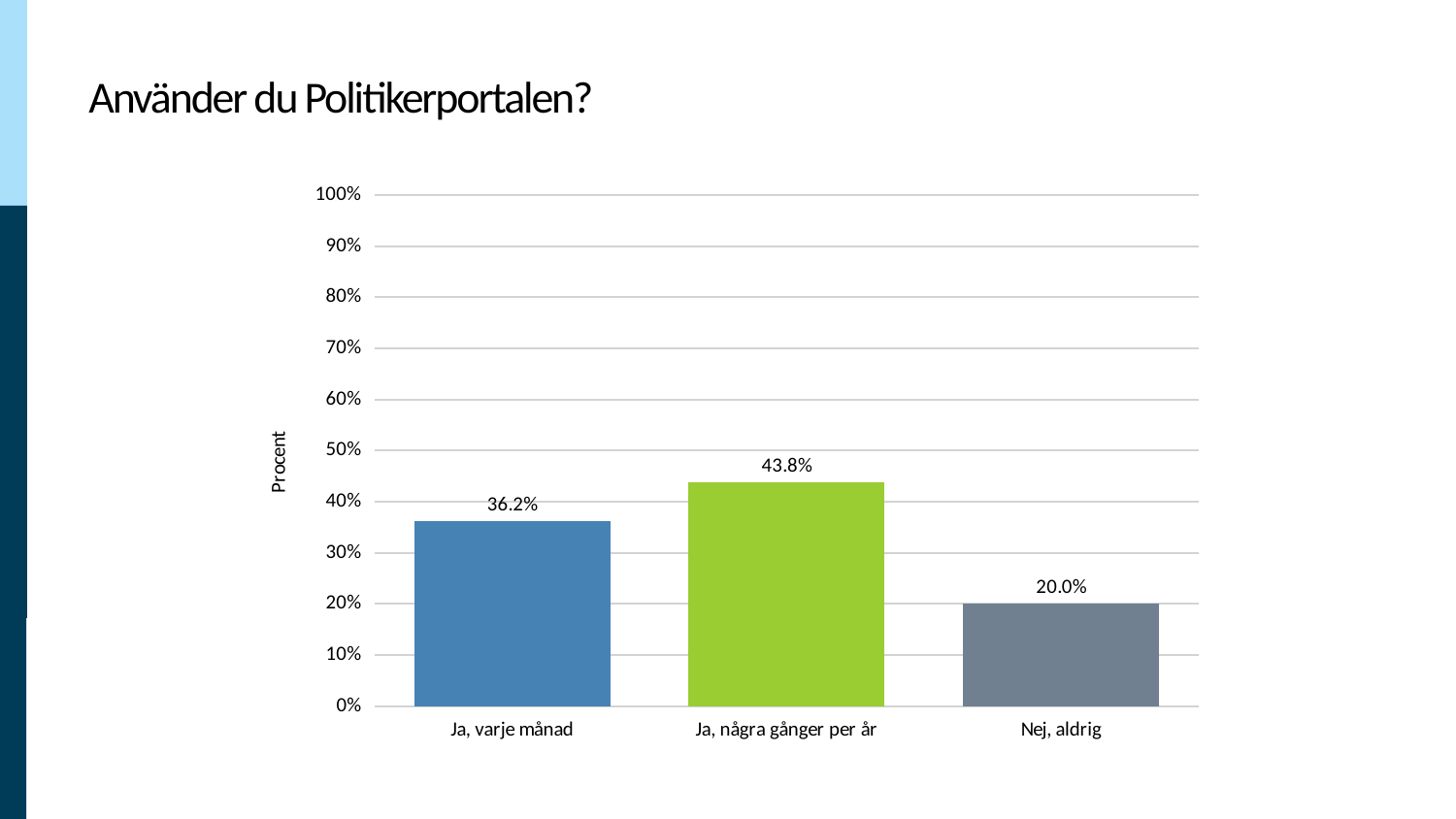
What is the label of the y axis? Procent What is the difference between the values for "Ja, varje månad" and "Nej, aldrig"? 16.2% What kind of chart is shown on the slide? bar chart What is the value for "Ja, varje månad"? 36.2% Is the value for "Ja, några gånger per år" greater or less than 50%? less Which category has the highest value? Ja, några gånger per år What is the value for "Nej, aldrig"? 20.0% What is the difference between the values for "Ja, några gånger per år" and "Ja, varje månad"? 7.6% Which category has the lowest value? Nej, aldrig How many categories are shown on the x axis? 3 Which is larger, the value for "Ja, varje månad" or the value for "Nej, aldrig"? Ja, varje månad What is the value for "Ja, några gånger per år"? 43.8%